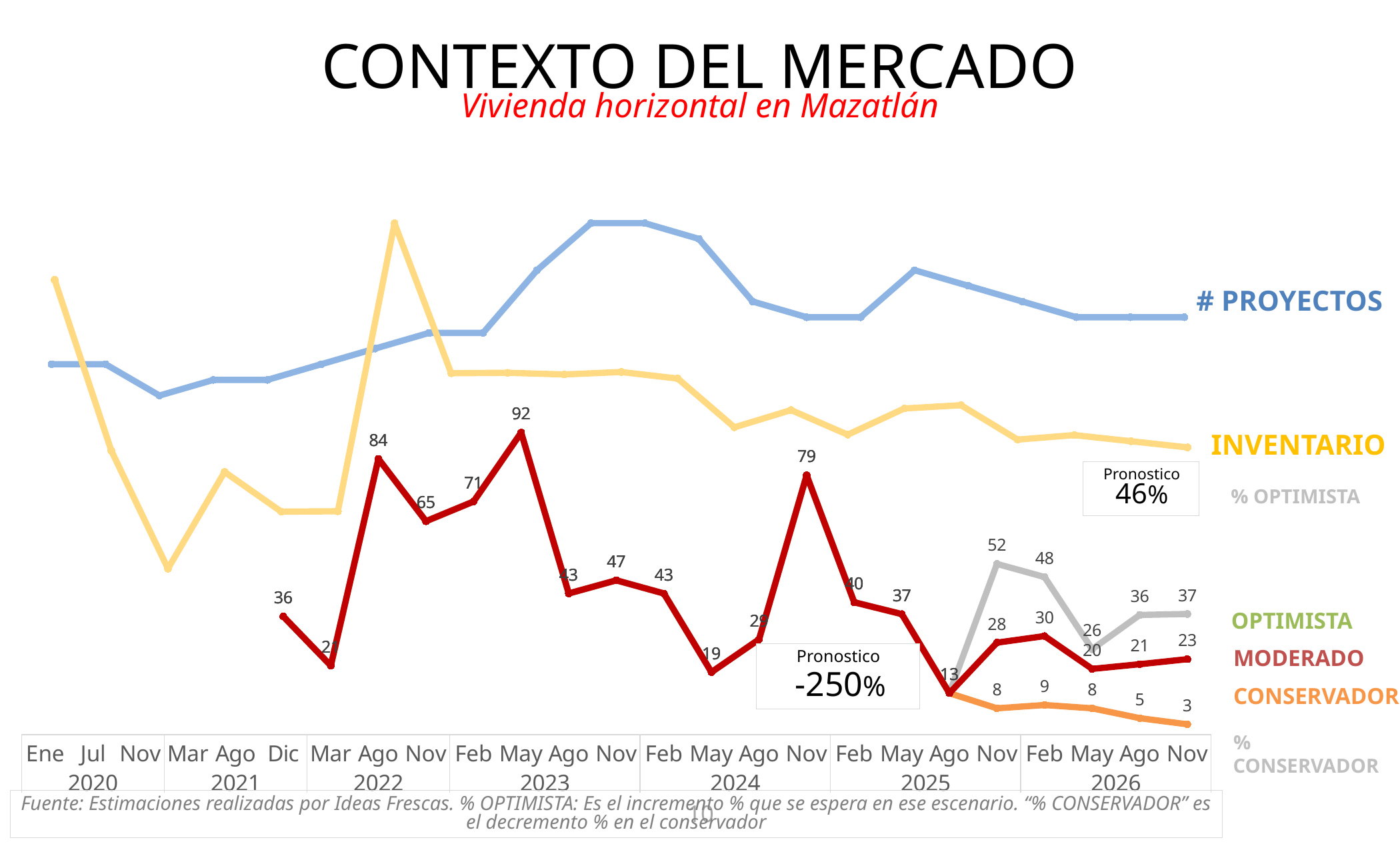
What kind of chart is shown on the slide? line chart What is the OPTIMISTA (gray) value labelled at Nov 2025? 52 How many labelled data points does the OPTIMISTA (gray) line have? 5 Does the CONSERVADOR (orange) line rise or fall from Feb 2026 to Nov 2026? fall What Pronostico value is shown in the box next to the % OPTIMISTA label? 46% What is the lowest labelled value on the MODERADO (red) line? 13 What is the MODERADO value labelled at Nov 2024? 79 Which is larger on the MODERADO line: the value at Ago 2022 or the value at Nov 2022? Ago 2022 What is the highest labelled value on the MODERADO (red) line? 92 At Nov 2026, what is the difference between the OPTIMISTA value (37) and the MODERADO value (23)? 14 What is the CONSERVADOR (orange) value labelled at Nov 2026? 3 What is the first labelled value on the MODERADO line, at Dic 2021? 36